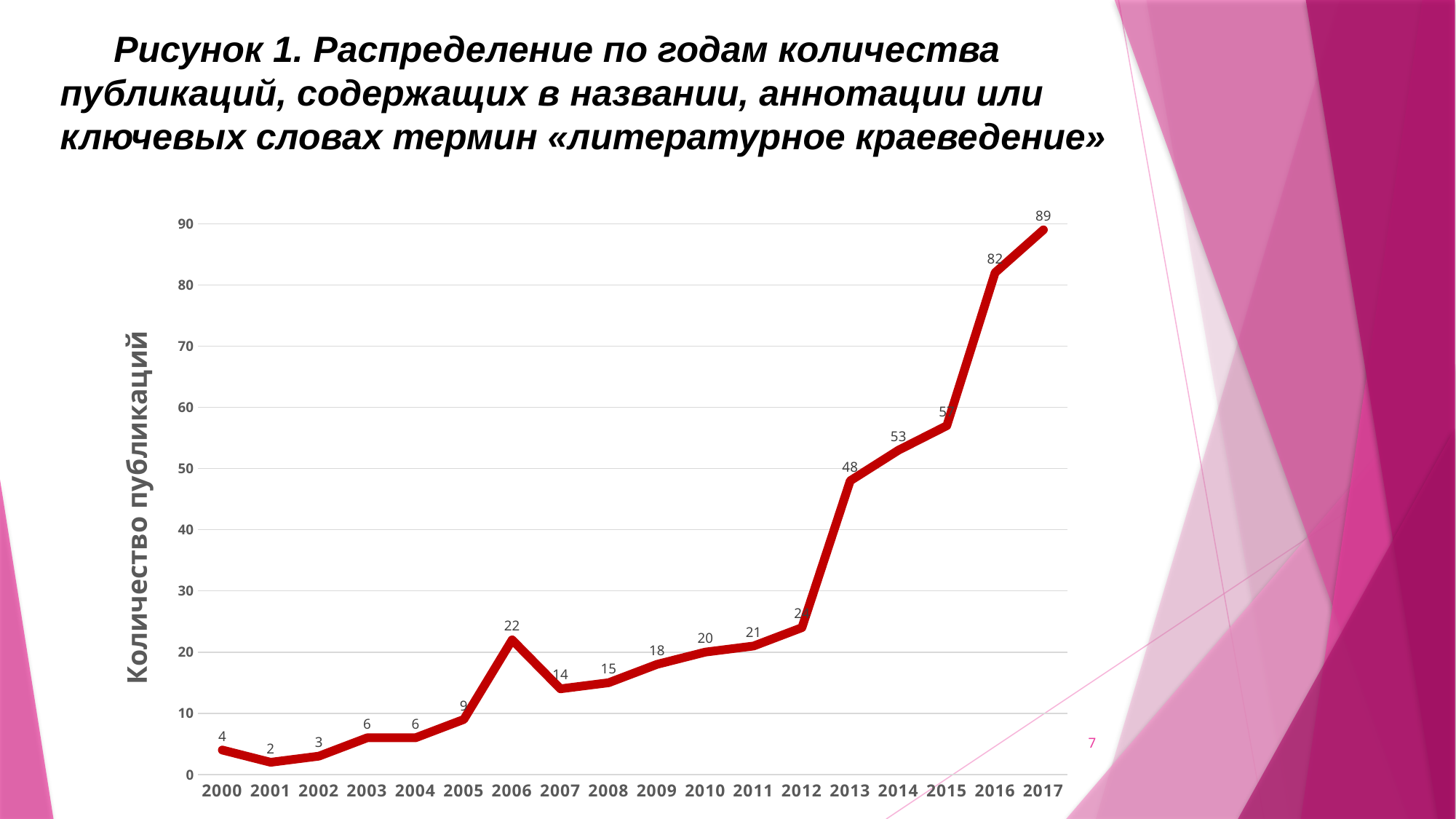
What is the value for 2017? 89 How many years are plotted on the x axis? 18 What is the difference between the values for 2006 and 2007? 8 How many publications are shown for 2006? 22 Which year has the lowest number of publications? 2001 What is the difference between the values for 2017 and 2016? 7 Which is larger, the value for 2014 or the value for 2010? 2014 What is the value for 2001? 2 What is the value for 2013? 48 Which year has the highest number of publications? 2017 What kind of chart is shown on the slide? line chart Is the value for 2015 greater or less than 50? greater